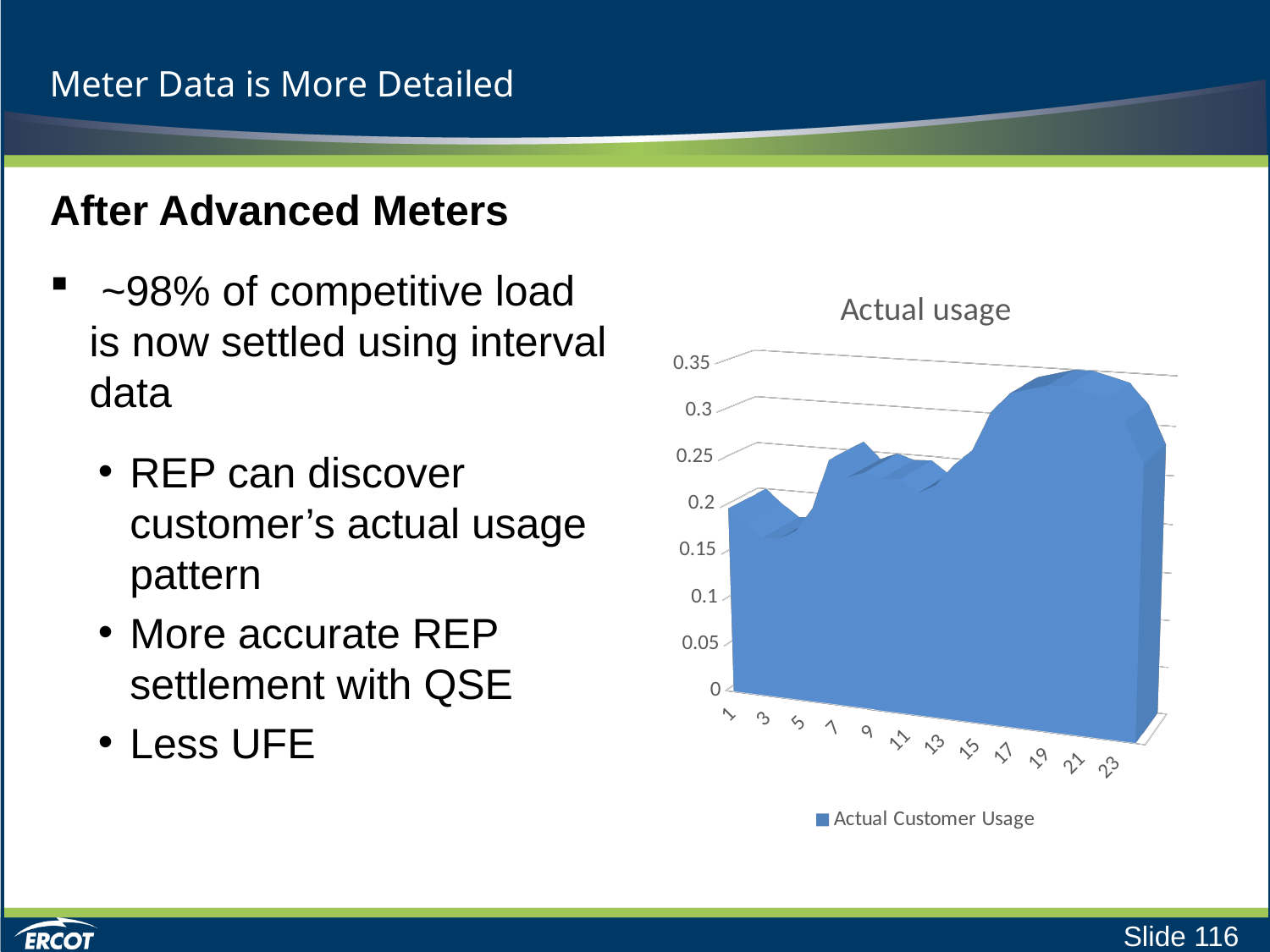
How many series does the legend of the chart list? 1 Is the value of Actual Customer Usage at x = 5 greater or less than 0.25? less Which is larger, the value of Actual Customer Usage at x = 21 or at x = 5? x = 21 Does Actual Customer Usage generally rise or fall from x = 11 to x = 21? rise Is the value of Actual Customer Usage at x = 1 greater or less than 0.1? greater Is the value of Actual Customer Usage at x = 21 greater or less than 0.2? greater How many labels are shown along the x axis of the chart? 12 What kind of chart is shown on the slide? area chart Does the highest point of the chart occur in the first half of the x axis (1 to 11) or the second half (13 to 23)? second half (13 to 23) What is the title of the chart? Actual usage What is the name of the series shown in the chart legend? Actual Customer Usage